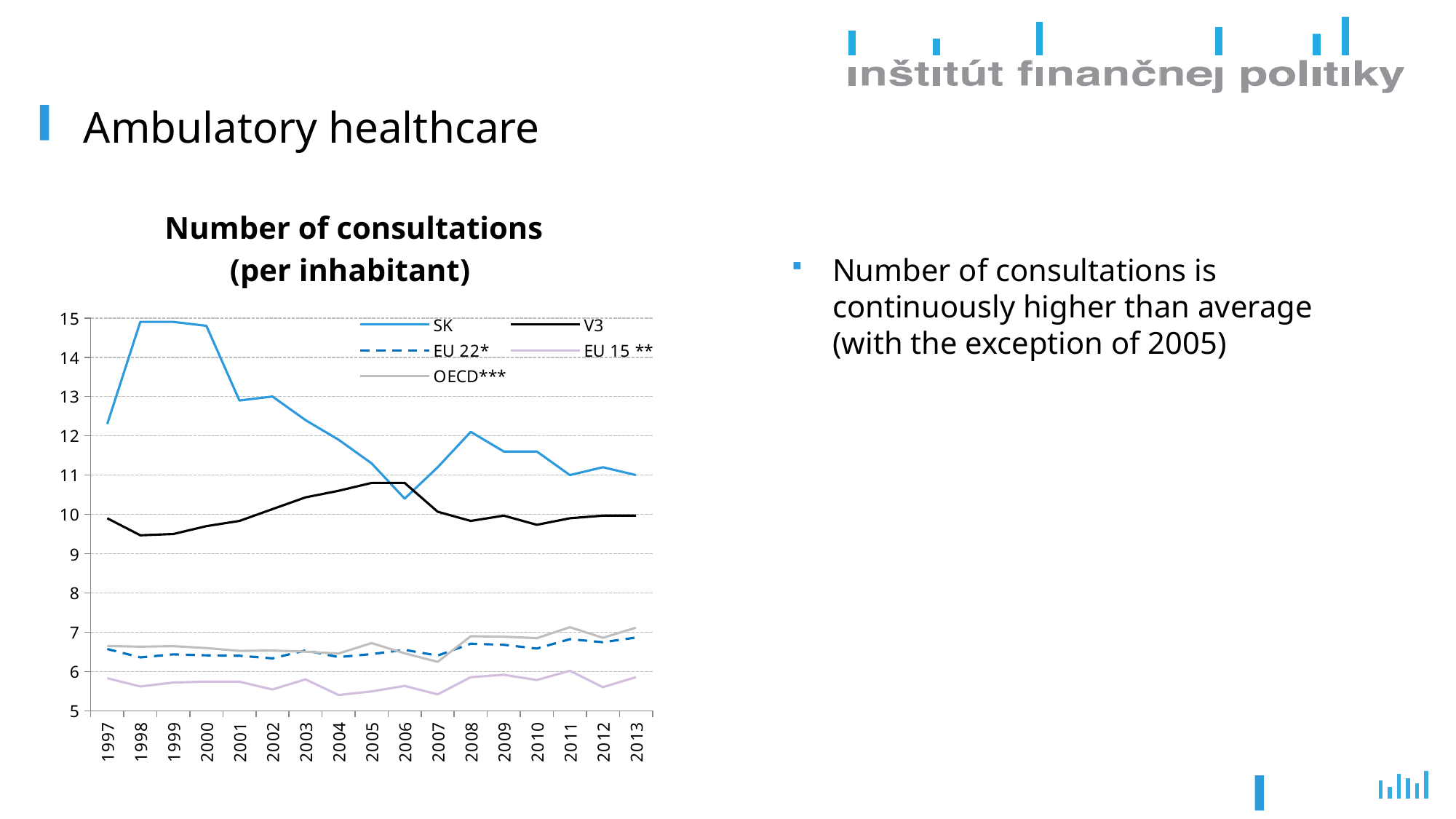
What kind of chart is shown on the slide? line chart Is the value for SK in 2006 greater or less than 11? less How many series does the legend of the chart list? 5 What is the title of the chart? Number of consultations (per inhabitant) Is the value for SK in 1998 greater or less than 14? greater Is the value for V3 in 1998 greater or less than 10? less Which series has the highest value in 2000? SK Does the SK series rise or fall between 2000 and 2006? fall Which series in the legend is drawn with a dashed line? EU 22* Which series has the lowest values across the whole period? EU 15 ** How many years are shown on the x axis of the chart? 17